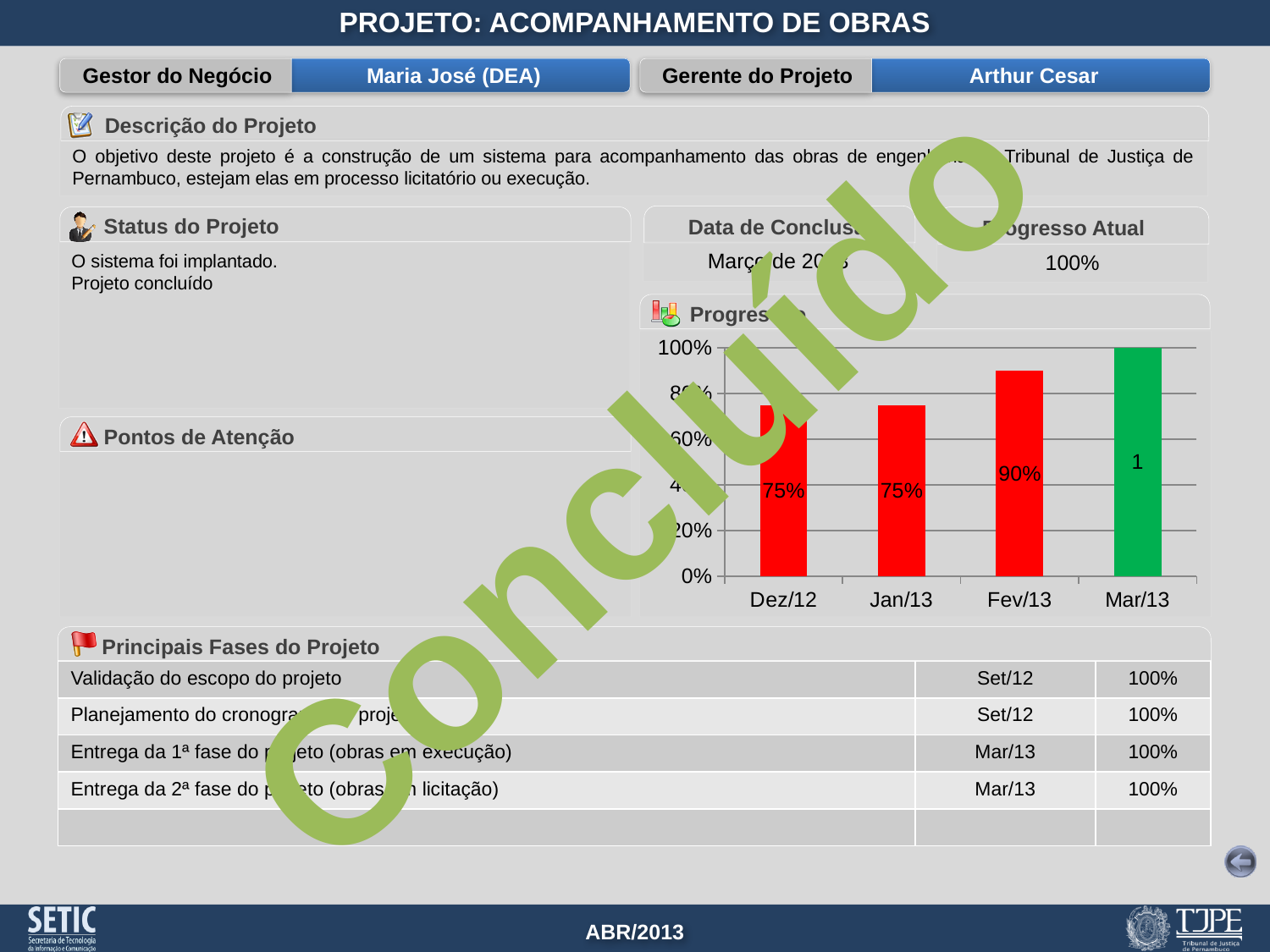
What kind of chart is the progress chart? bar chart Do the values in the progress chart rise or fall from Dez/12 to Mar/13? rise What is the difference between the values for Fev/13 and Dez/12 in the progress chart? 15% What is the value shown for Dez/12 in the progress chart? 75% Which is larger in the progress chart, the value for Fev/13 or the value for Jan/13? Fev/13 What data label is printed on the Mar/13 bar in the progress chart? 1 What colour is the Mar/13 bar in the progress chart? green Which month has the highest bar in the progress chart? Mar/13 How many months are shown on the x axis of the progress chart? 4 Is the value for Mar/13 in the progress chart greater or less than 80%? greater What is the value shown for Jan/13 in the progress chart? 75% What is the value shown for Fev/13 in the progress chart? 90%